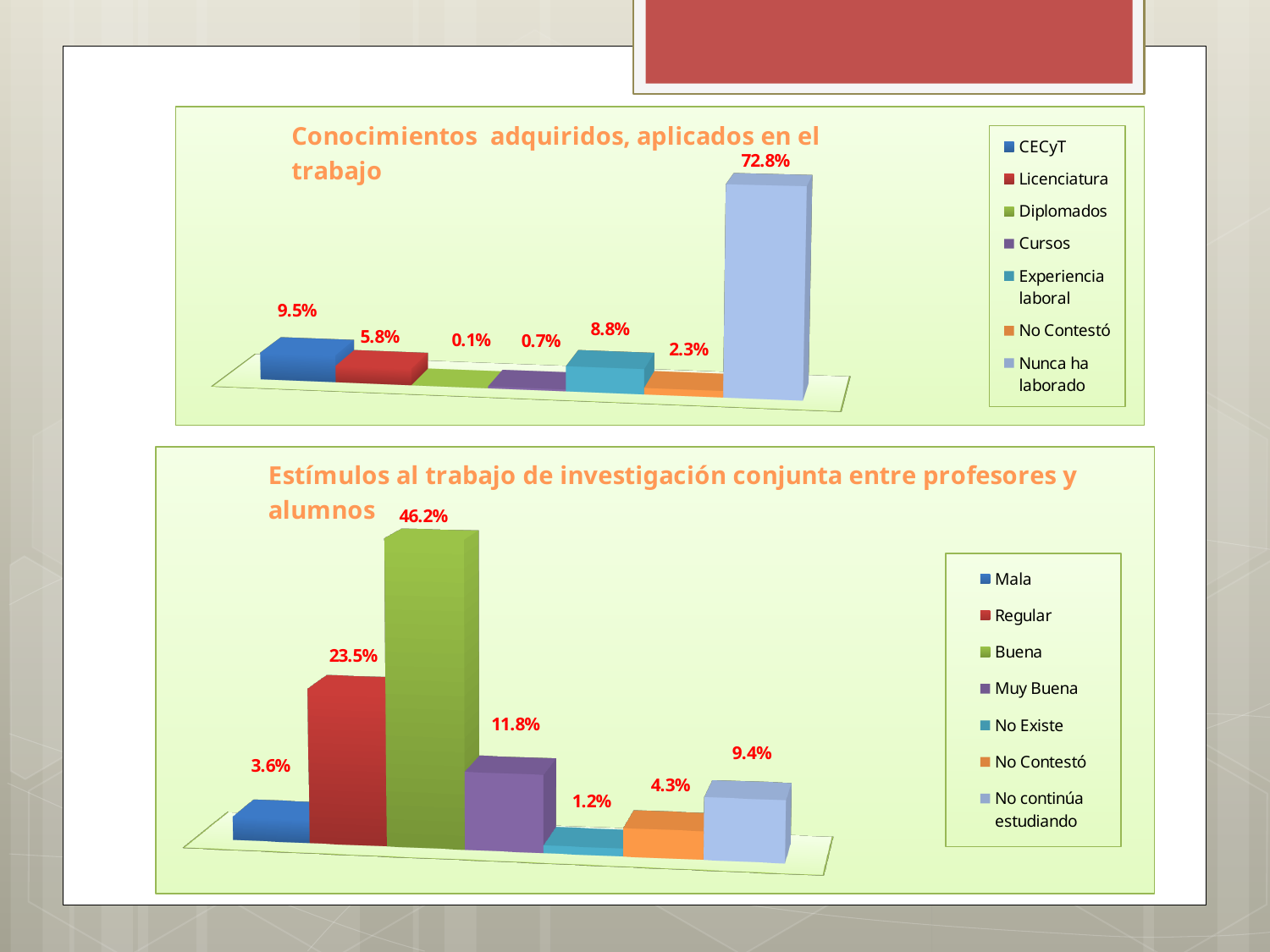
In the chart titled 'Conocimientos adquiridos, aplicados en el trabajo', which is larger, Cursos or No Contestó? No Contestó In the chart titled 'Estímulos al trabajo de investigación conjunta entre profesores y alumnos', what is the value for Buena? 46.2% In the chart titled 'Estímulos al trabajo de investigación conjunta entre profesores y alumnos', which category has the lowest value? No Existe In the chart titled 'Estímulos al trabajo de investigación conjunta entre profesores y alumnos', what is the value for No continúa estudiando? 9.4% In the chart titled 'Conocimientos adquiridos, aplicados en el trabajo', which category has the lowest value? Diplomados In the chart titled 'Conocimientos adquiridos, aplicados en el trabajo', what is the difference between CECyT and Licenciatura? 3.7% What kind of chart is the bottom chart on the slide? Bar chart In the chart titled 'Conocimientos adquiridos, aplicados en el trabajo', what is the value for Nunca ha laborado? 72.8% In the chart titled 'Estímulos al trabajo de investigación conjunta entre profesores y alumnos', which category has the highest value? Buena In the chart titled 'Conocimientos adquiridos, aplicados en el trabajo', how many entries does the legend list? 7 In the chart titled 'Conocimientos adquiridos, aplicados en el trabajo', what is the value for Experiencia laboral? 8.8% In the chart titled 'Estímulos al trabajo de investigación conjunta entre profesores y alumnos', what is the difference between Regular and Muy Buena? 11.7%